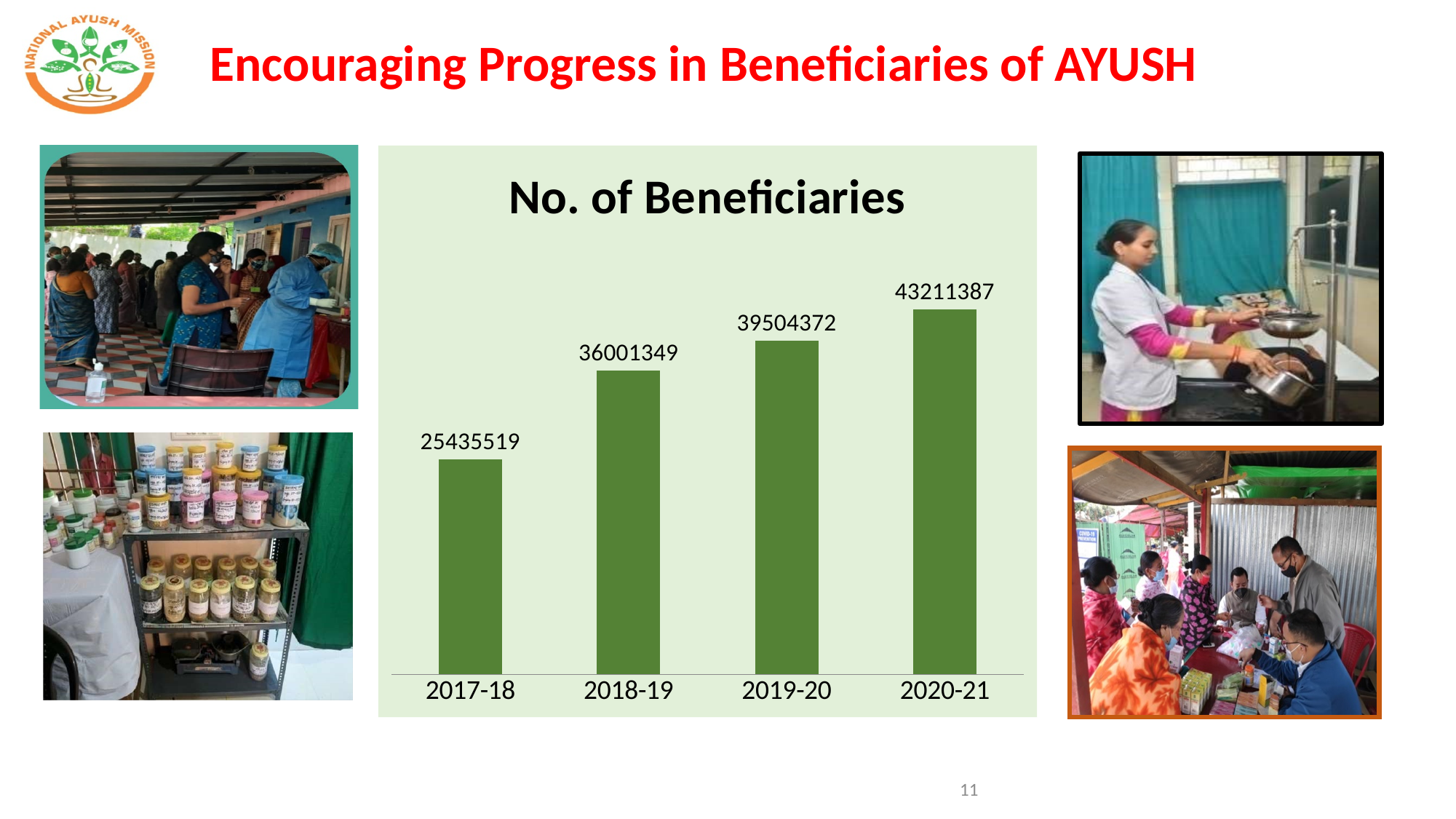
Which year has the highest number of beneficiaries? 2020-21 What is the number of beneficiaries for 2018-19? 36001349 What is the difference in the number of beneficiaries between 2020-21 and 2019-20? 3707015 What is the number of beneficiaries for 2017-18? 25435519 Which year has more beneficiaries, 2018-19 or 2019-20? 2019-20 Which year has the lowest number of beneficiaries? 2017-18 What is the number of beneficiaries for 2020-21? 43211387 What is the number of beneficiaries for 2019-20? 39504372 Do the number of beneficiaries rise or fall from 2017-18 to 2020-21? Rise What is the difference in the number of beneficiaries between 2018-19 and 2017-18? 10565830 What kind of chart is shown on the slide? Bar chart How many years are shown on the chart? 4